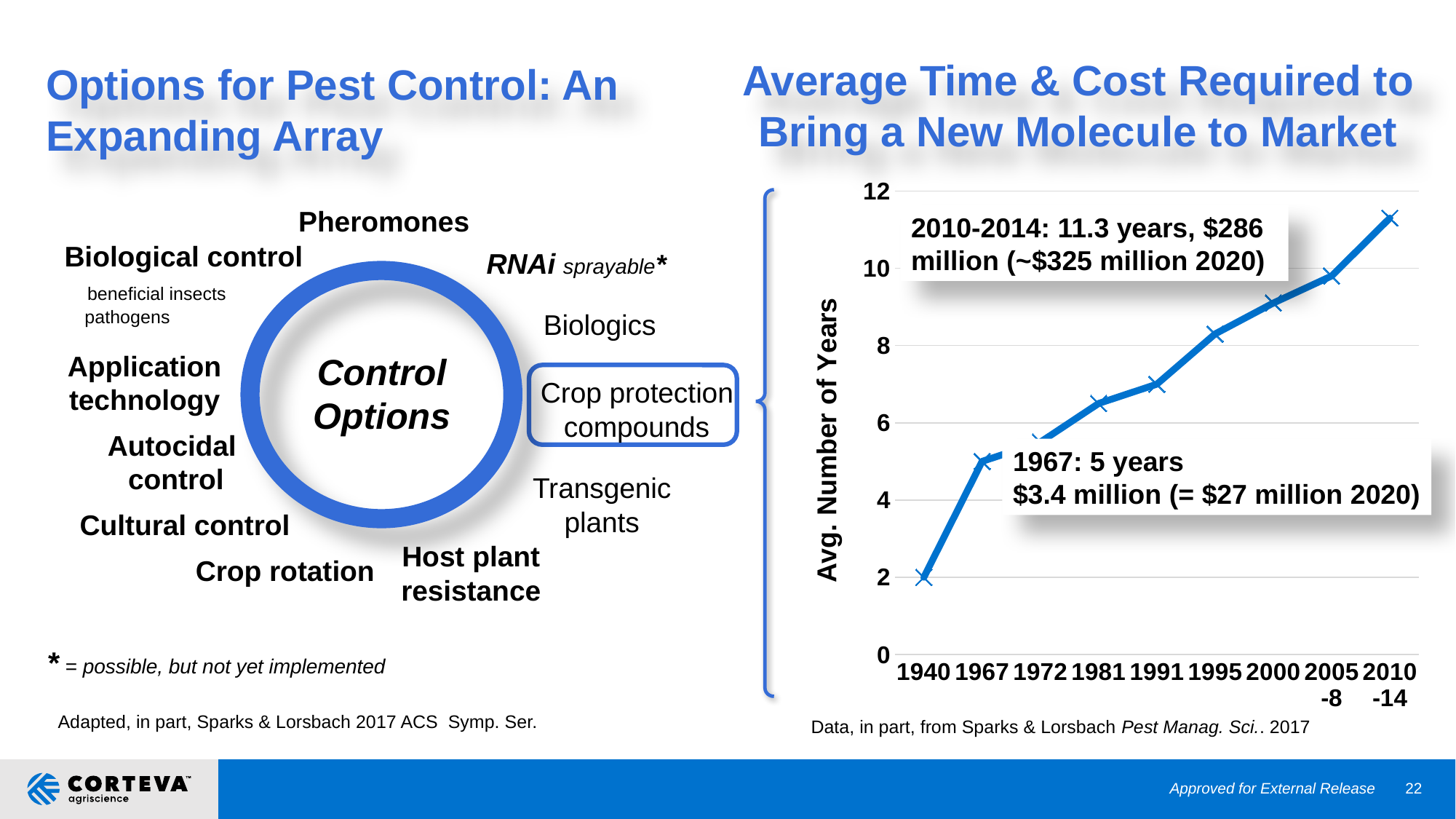
What is the label on the y-axis of the line chart? Avg. Number of Years According to the annotation on the line chart, what was the average number of years in 1967? 5 years Is the value for 1981 on the line chart greater or less than 6? greater Using the annotated values, how many more years did it take in 2010-2014 than in 1967? 6.3 years Do the values on the line chart rise or fall from 1940 to 2010-14? rise Is the value for 2005-8 on the line chart greater or less than 8? greater According to the annotation on the line chart, what was the average number of years for 2010-2014? 11.3 years Which period on the line chart has the highest average number of years? 2010-14 Which has a larger value on the line chart, 1972 or 1991? 1991 Which year on the line chart has the lowest average number of years? 1940 How many data points are plotted on the line chart? 9 What kind of chart is shown under the title "Average Time & Cost Required to Bring a New Molecule to Market"? line chart